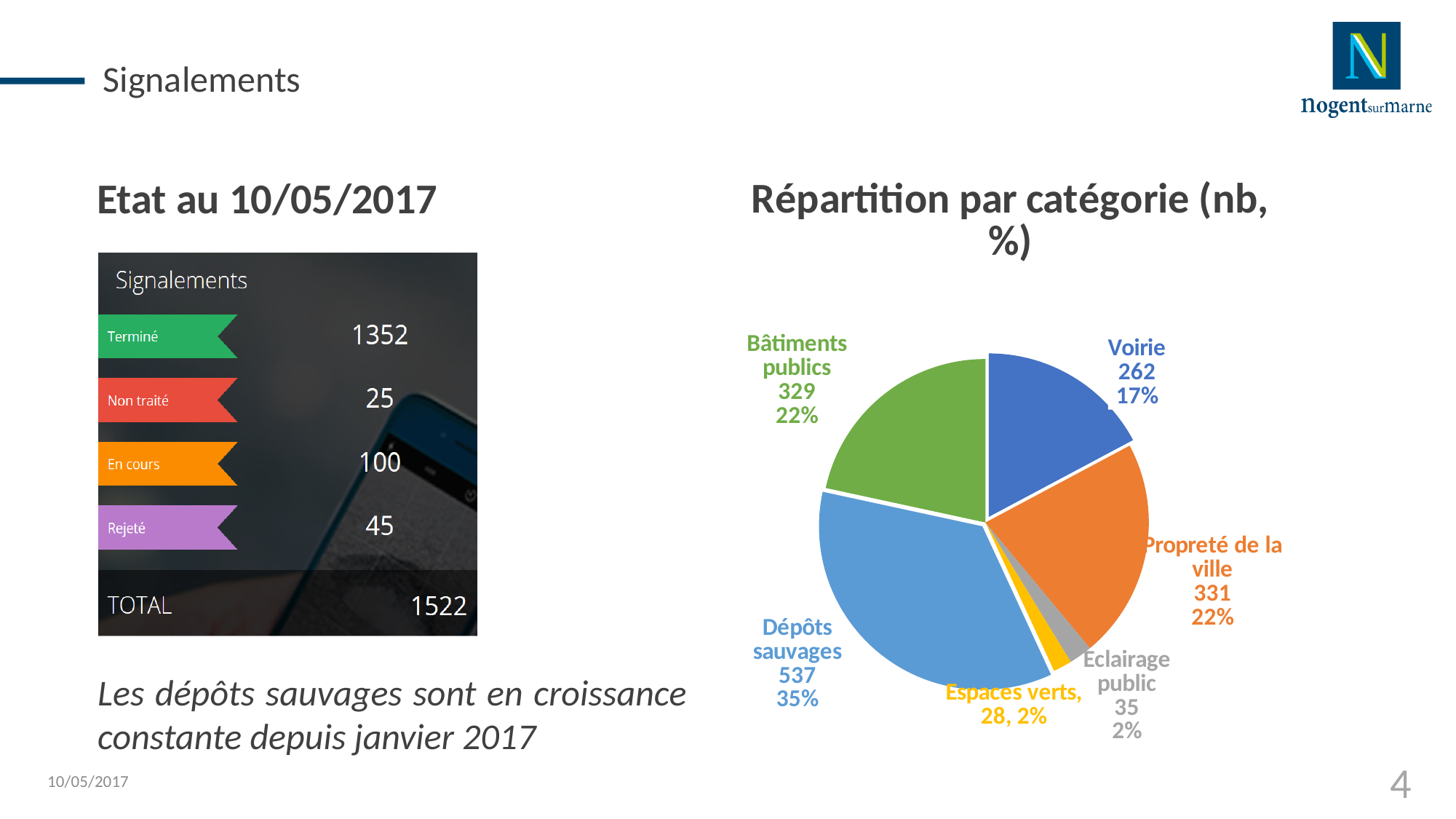
In the pie chart, what is the number of signalements for Dépôts sauvages? 537 In the pie chart, which is larger: Voirie or Bâtiments publics? Bâtiments publics What share of the pie does Dépôts sauvages represent? 35% Which category has the largest slice in the pie chart? Dépôts sauvages Which category has the smallest slice in the pie chart? Espaces verts In the pie chart, what is the number for Voirie? 262 How many categories does the pie chart "Répartition par catégorie (nb, %)" show? 6 In the pie chart, what is the number for Propreté de la ville? 331 What type of chart is shown under the title "Répartition par catégorie (nb, %)"? pie chart In the pie chart, what is the number for Eclairage public? 35 In the pie chart, what is the difference between the values for Dépôts sauvages and Voirie? 275 What share of the pie does Bâtiments publics represent? 22%